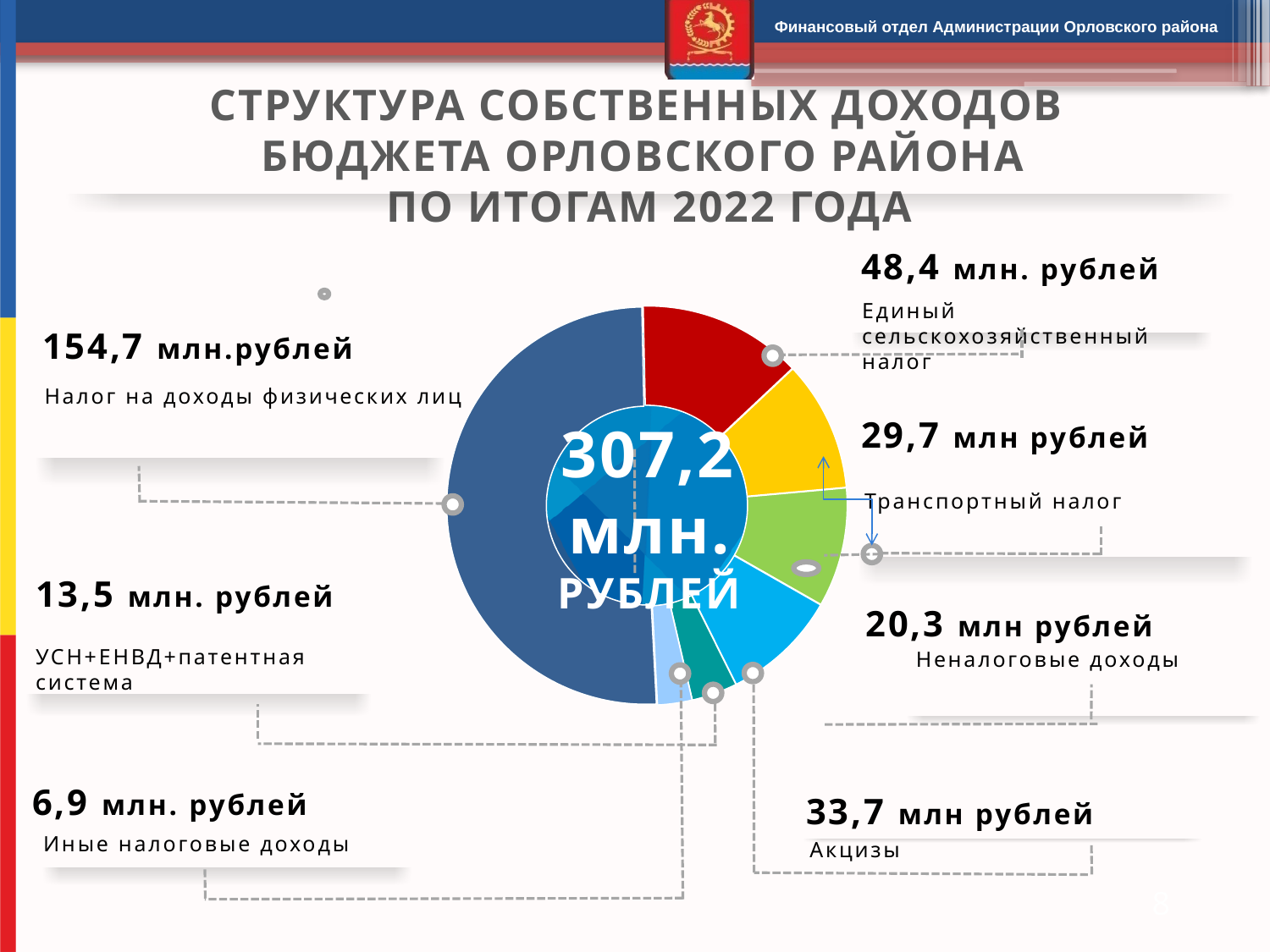
What total value is printed in the centre of the chart? 307,2 млн. рублей Which category has the smallest value? Иные налоговые доходы Which is larger, Акцизы or Транспортный налог? Акцизы What is the value shown for Транспортный налог? 29,7 млн рублей Which category has the largest value? Налог на доходы физических лиц What is the value shown for Акцизы? 33,7 млн рублей What is the value shown for Единый сельскохозяйственный налог? 48,4 млн. рублей What is the difference between Налог на доходы физических лиц and Единый сельскохозяйственный налог? 106,3 млн. рублей What is the value shown for Иные налоговые доходы? 6,9 млн. рублей What is the value shown for Налог на доходы физических лиц? 154,7 млн.рублей What kind of chart is shown on the slide? Pie (donut) chart How many categories are shown in the chart? 7